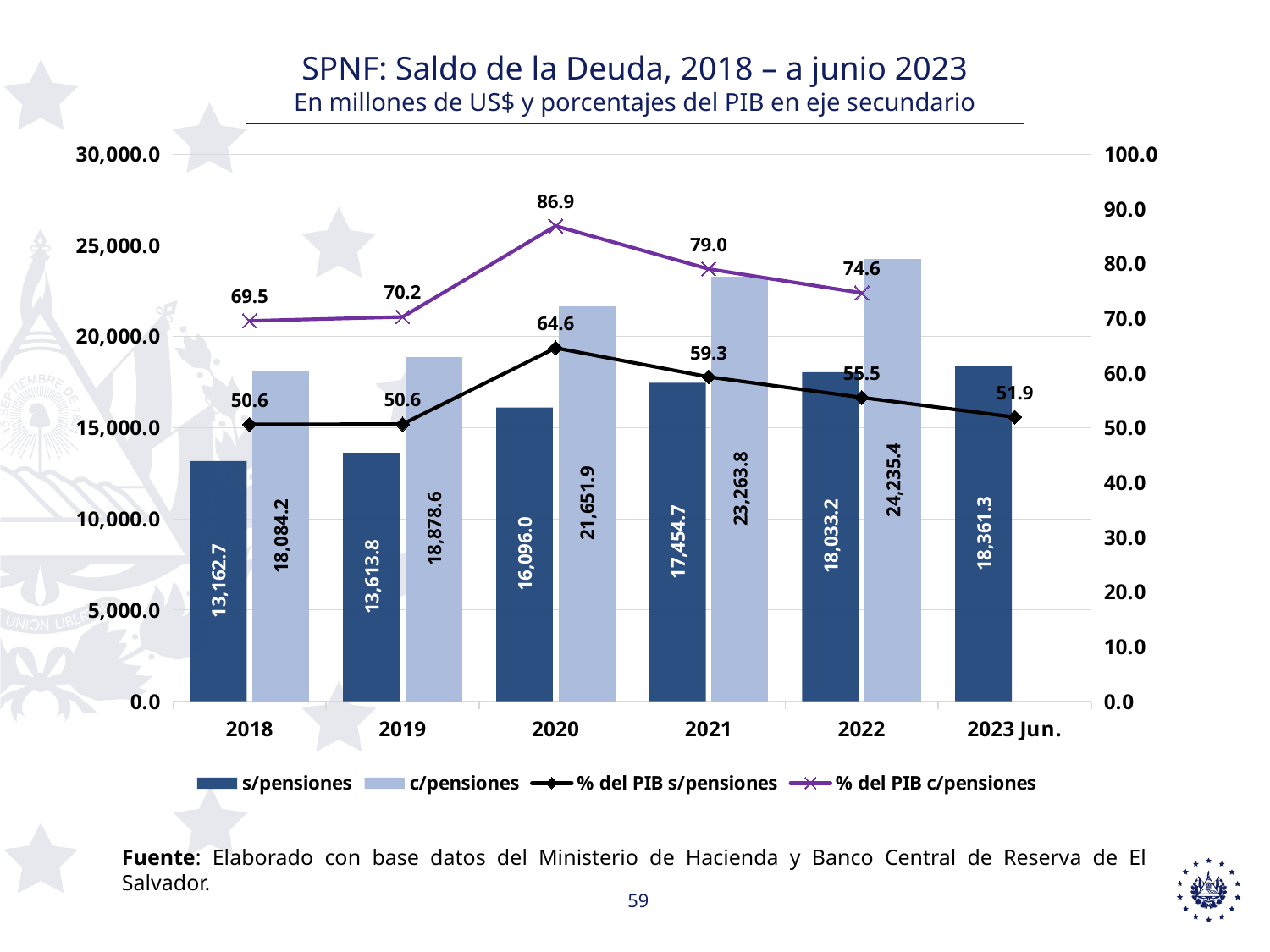
How many series does the legend list? 4 What is the value of % del PIB s/pensiones for 2023 Jun.? 51.9 What is the value of % del PIB c/pensiones for 2020? 86.9 Which year has the highest c/pensiones value? 2022 How many categories are shown on the x axis? 6 Does % del PIB s/pensiones rise or fall from 2020 to 2023 Jun.? fall What is the difference between c/pensiones and s/pensiones in 2021? 5,809.1 What is the value of c/pensiones for 2022? 24,235.4 Which is larger, s/pensiones for 2022 or for 2023 Jun.? 2023 Jun. Which category has the highest % del PIB s/pensiones value? 2020 Which category has the lowest s/pensiones value? 2018 What is the value of s/pensiones for 2020? 16,096.0